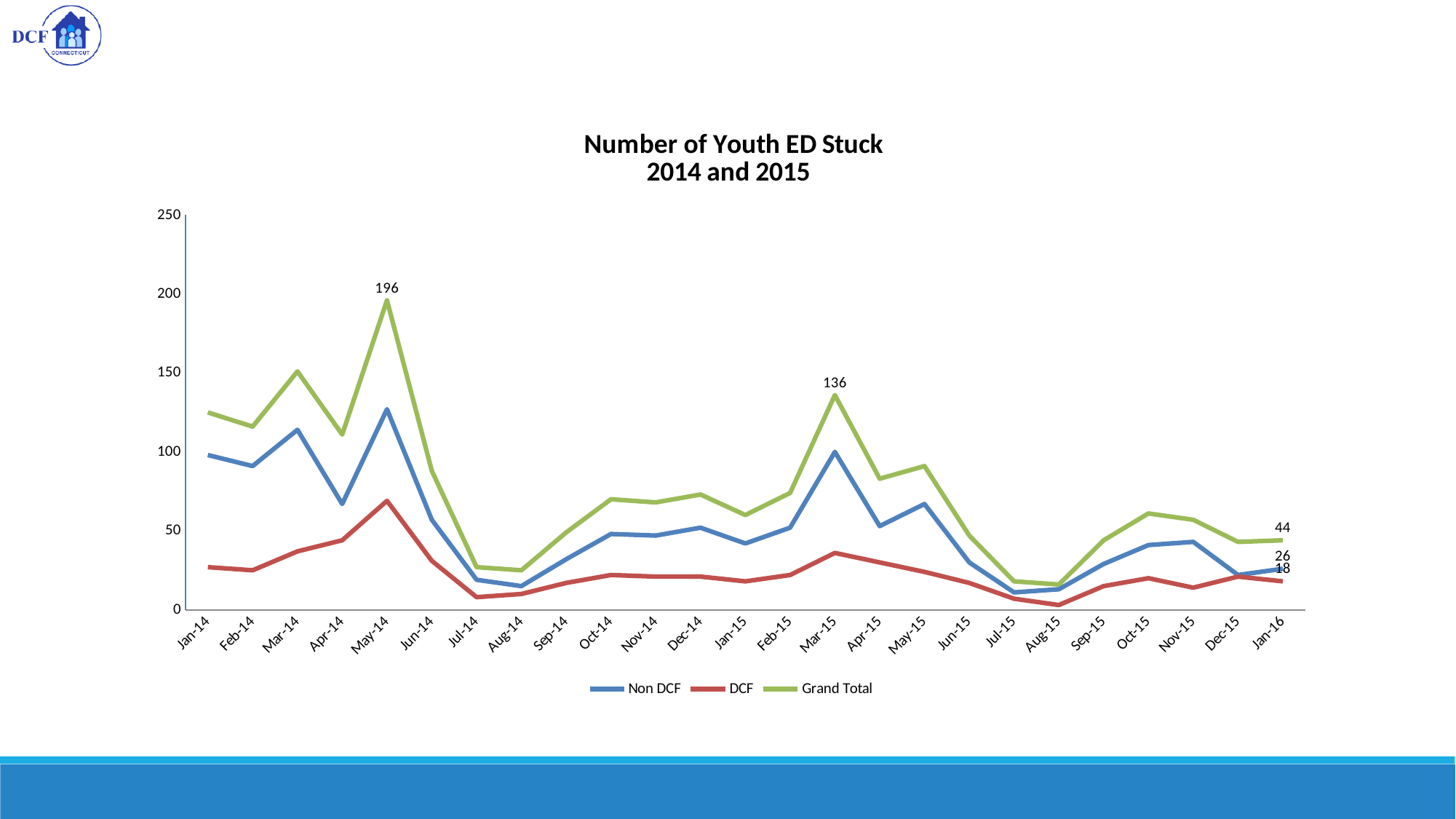
How many months are plotted along the x axis? 25 Is the Non DCF value for May-14 greater or less than 100? greater How many series does the legend list? 3 In which month does the Grand Total series reach its highest value? May-14 What is the DCF value for Jan-16? 18 What is the Grand Total value for Jan-16? 44 What kind of chart is shown on the slide? line chart What is the Grand Total value for May-14? 196 What is the difference between the Grand Total values for May-14 and Mar-15? 60 What is the Non DCF value for Jan-16? 26 Which is larger, the Grand Total for May-14 or the Grand Total for Mar-15? May-14 What is the Grand Total value for Mar-15? 136